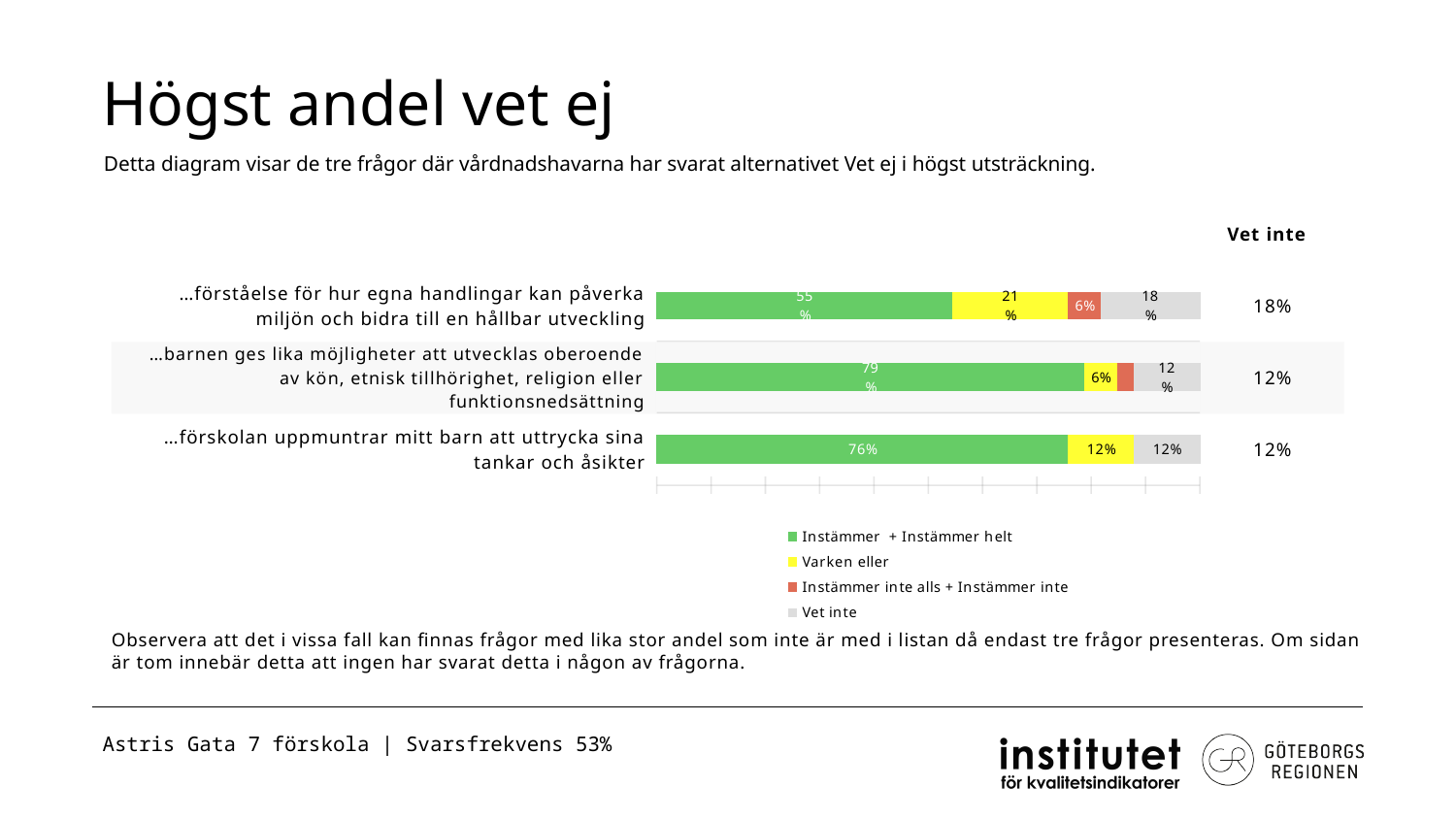
What is the difference between the 'Varken eller' values for '…förståelse för hur egna handlingar kan påverka miljön och bidra till en hållbar utveckling' and '…förskolan uppmuntrar mitt barn att uttrycka sina tankar och åsikter'? 9% How many categories (questions) are plotted in the chart? 3 What is the 'Varken eller' value for '…förskolan uppmuntrar mitt barn att uttrycka sina tankar och åsikter'? 12% What is the 'Instämmer + Instämmer helt' value for '…barnen ges lika möjligheter att utvecklas oberoende av kön, etnisk tillhörighet, religion eller funktionsnedsättning'? 79% How many series does the legend list? 4 Which is larger: the 'Instämmer + Instämmer helt' value for '…förskolan uppmuntrar mitt barn att uttrycka sina tankar och åsikter' or for '…förståelse för hur egna handlingar kan påverka miljön och bidra till en hållbar utveckling'? …förskolan uppmuntrar mitt barn att uttrycka sina tankar och åsikter What is the 'Vet inte' value for '…förståelse för hur egna handlingar kan påverka miljön och bidra till en hållbar utveckling'? 18% What kind of chart is shown on the slide? stacked bar chart Which category has the highest 'Instämmer + Instämmer helt' share? …barnen ges lika möjligheter att utvecklas oberoende av kön, etnisk tillhörighet, religion eller funktionsnedsättning What is the title of the slide containing the chart? Högst andel vet ej Which category has the highest 'Vet inte' share? …förståelse för hur egna handlingar kan påverka miljön och bidra till en hållbar utveckling What is the 'Instämmer + Instämmer helt' value for '…förståelse för hur egna handlingar kan påverka miljön och bidra till en hållbar utveckling'? 55%